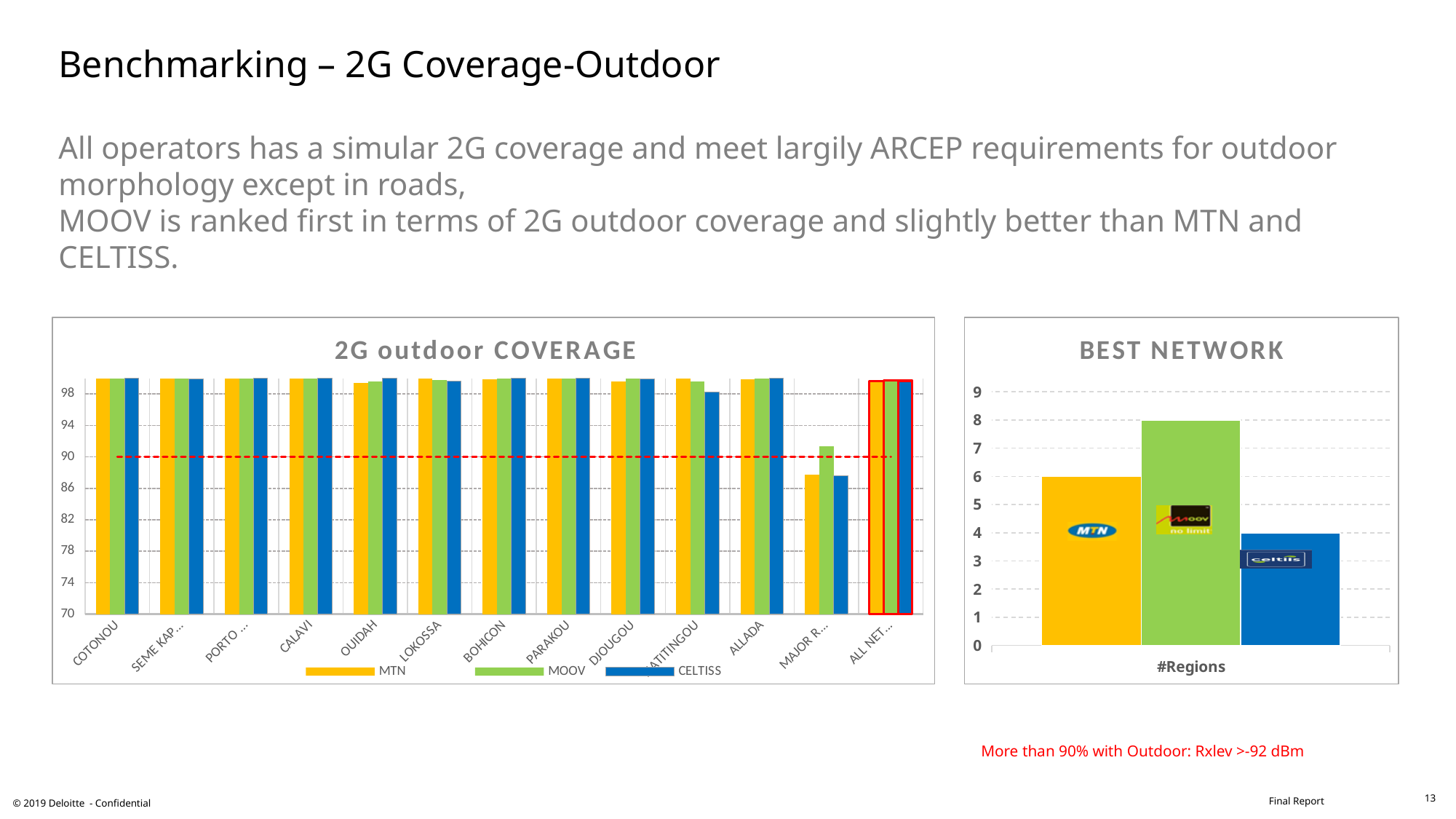
In the "2G outdoor COVERAGE" chart, is the CELTISS value for COTONOU greater or less than 98? greater In the "2G outdoor COVERAGE" chart, is the MTN value for MAJOR R... greater or less than 90? less In the "2G outdoor COVERAGE" chart, which category has the lowest CELTISS value? MAJOR R... Which series are listed in the legend of the "2G outdoor COVERAGE" chart? MTN, MOOV, CELTISS How many series does the legend of the "2G outdoor COVERAGE" chart list? 3 In the "BEST NETWORK" chart, what is the difference between the MOOV value and the MTN value? 2 In the "BEST NETWORK" chart, what is the value for MTN? 6 In the "BEST NETWORK" chart, which is larger, the value for MTN or the value for CELTISS? MTN In the "BEST NETWORK" chart, which operator has the lowest value? CELTISS What kind of chart is the "2G outdoor COVERAGE" chart? Combination bar and line chart How many categories are shown on the x axis of the "2G outdoor COVERAGE" chart? 13 In the "BEST NETWORK" chart, what is the value for MOOV? 8